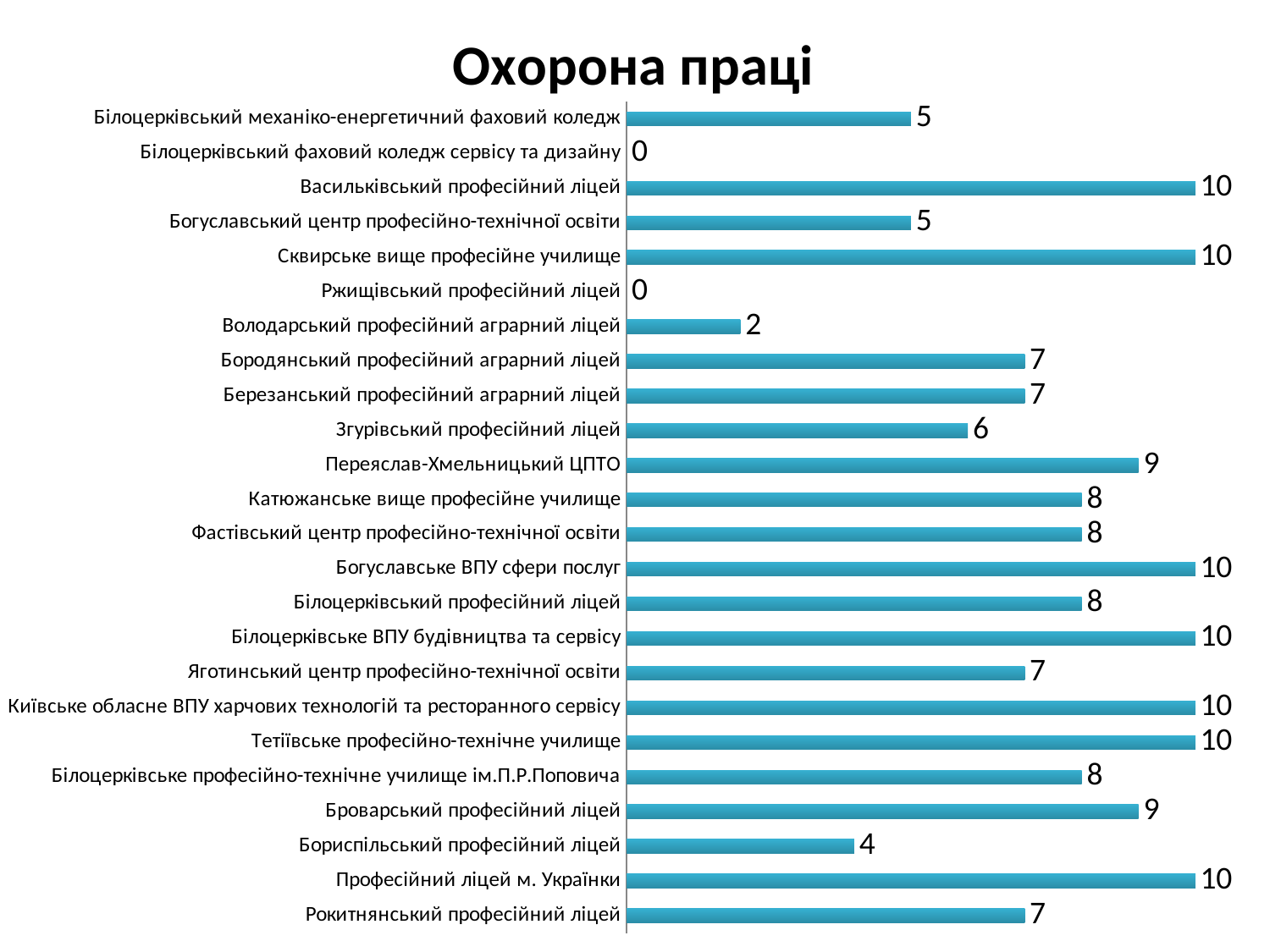
What is the highest value shown on the chart? 10 How many categories are shown on the chart? 24 What is the title of the chart? Охорона праці What is the value for Ржищівський професійний ліцей? 0 What is the difference between the values for Васильківський професійний ліцей and Богуславський центр професійно-технічної освіти? 5 What is the value for Згурівський професійний ліцей? 6 What is the value for Бориспільський професійний ліцей? 4 What is the lowest value shown on the chart? 0 What kind of chart is shown on the slide? Bar chart What is the value for Володарський професійний аграрний ліцей? 2 Which has a larger value, Броварський професійний ліцей or Бориспільський професійний ліцей? Броварський професійний ліцей What is the value for Переяслав-Хмельницький ЦПТО? 9